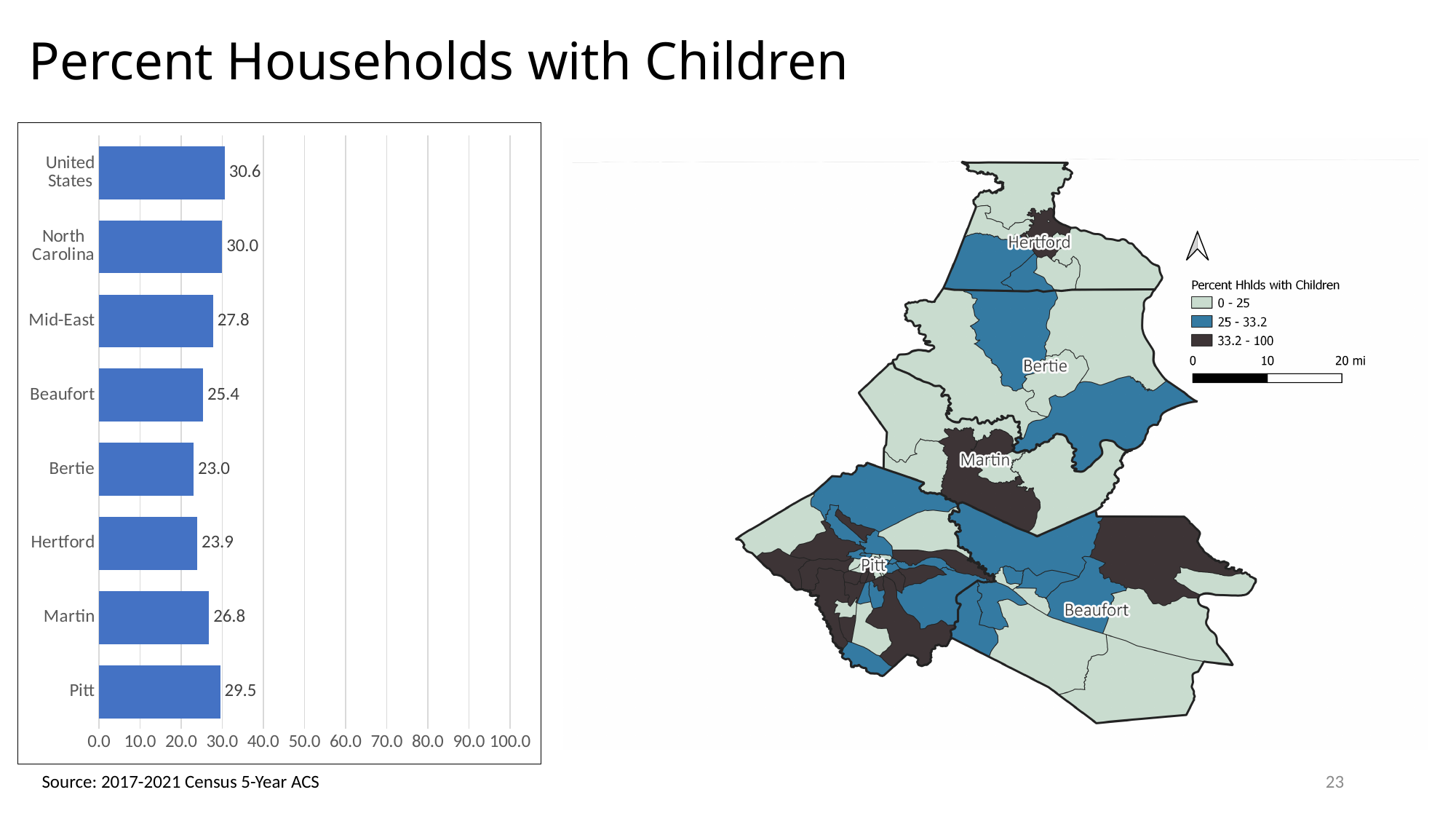
What kind of chart is shown on the left of the slide? bar chart How many categories are shown in the bar chart? 8 Which category has the lowest value in the bar chart? Bertie Which has a larger value in the bar chart, Martin or Hertford? Martin What is the value for Bertie in the bar chart? 23.0 Is the value for Mid-East in the bar chart greater or less than 30.0? less What is the value for the United States in the bar chart? 30.6 What is the difference between the values for North Carolina and Beaufort in the bar chart? 4.6 Which category has the highest value in the bar chart? United States What is the value for Pitt in the bar chart? 29.5 What is the maximum value shown on the x axis of the bar chart? 100.0 What is the difference between the values for Pitt and Bertie in the bar chart? 6.5